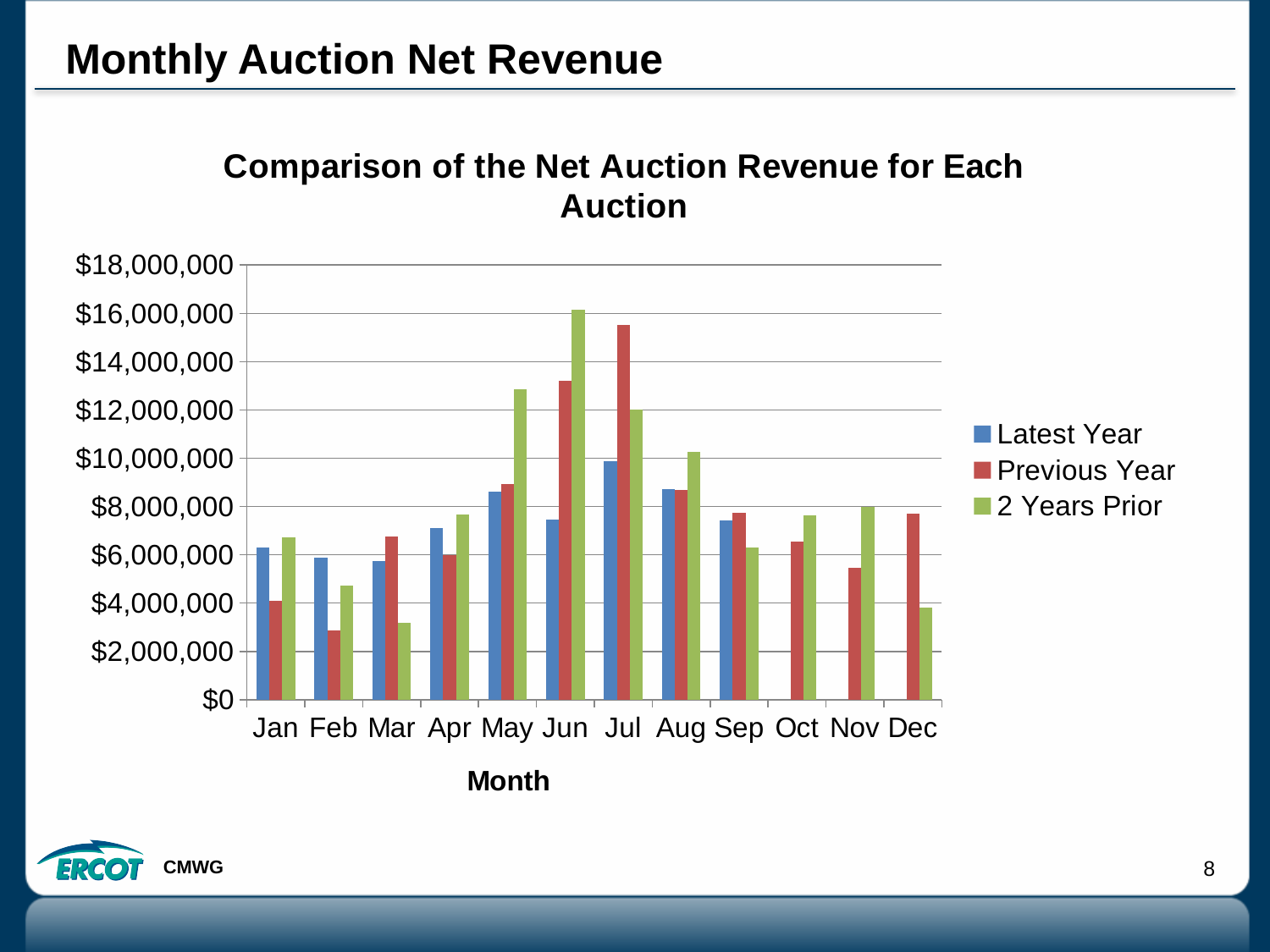
How many months are shown on the x axis? 12 What is the title of the x axis? Month Is the Latest Year value for Jul greater or less than $8,000,000? greater In which month is the Latest Year value highest? Jul In which month is the Previous Year value highest? Jul In which month is the 2 Years Prior value highest? Jun What kind of chart is shown on the slide? Bar chart For Jun, which is larger: the Previous Year value or the 2 Years Prior value? 2 Years Prior How many series does the legend list? 3 For Jan, which is larger: the Latest Year value or the Previous Year value? Latest Year Is the 2 Years Prior value for Mar greater or less than $4,000,000? less In which month is the Previous Year value lowest? Feb